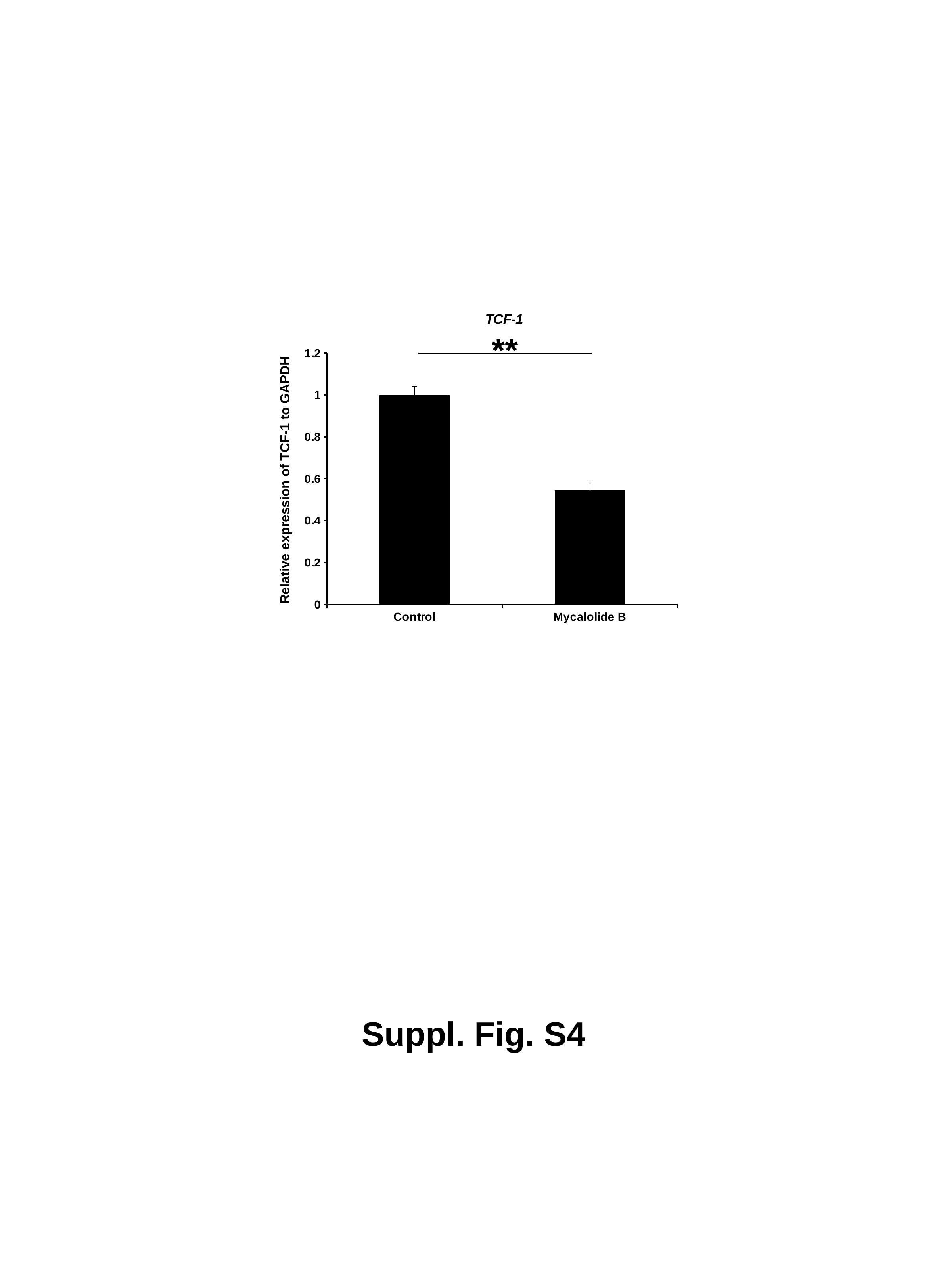
What is the label of the y axis of the chart? Relative expression of TCF-1 to GAPDH Do the values rise or fall from Control to Mycalolide B? fall What is the value for Control in the chart? 1 Which category has the highest value in the chart? Control Which category has the lowest value in the chart? Mycalolide B Is the value for Control greater or less than 0.8? greater What is the title of the chart? TCF-1 Is the value for Mycalolide B greater or less than 0.6? less Is the value for Mycalolide B greater or less than 0.4? greater Which is larger, the value for Control or the value for Mycalolide B? Control What kind of chart is shown on the slide? bar chart How many categories are shown on the x axis of the chart? 2